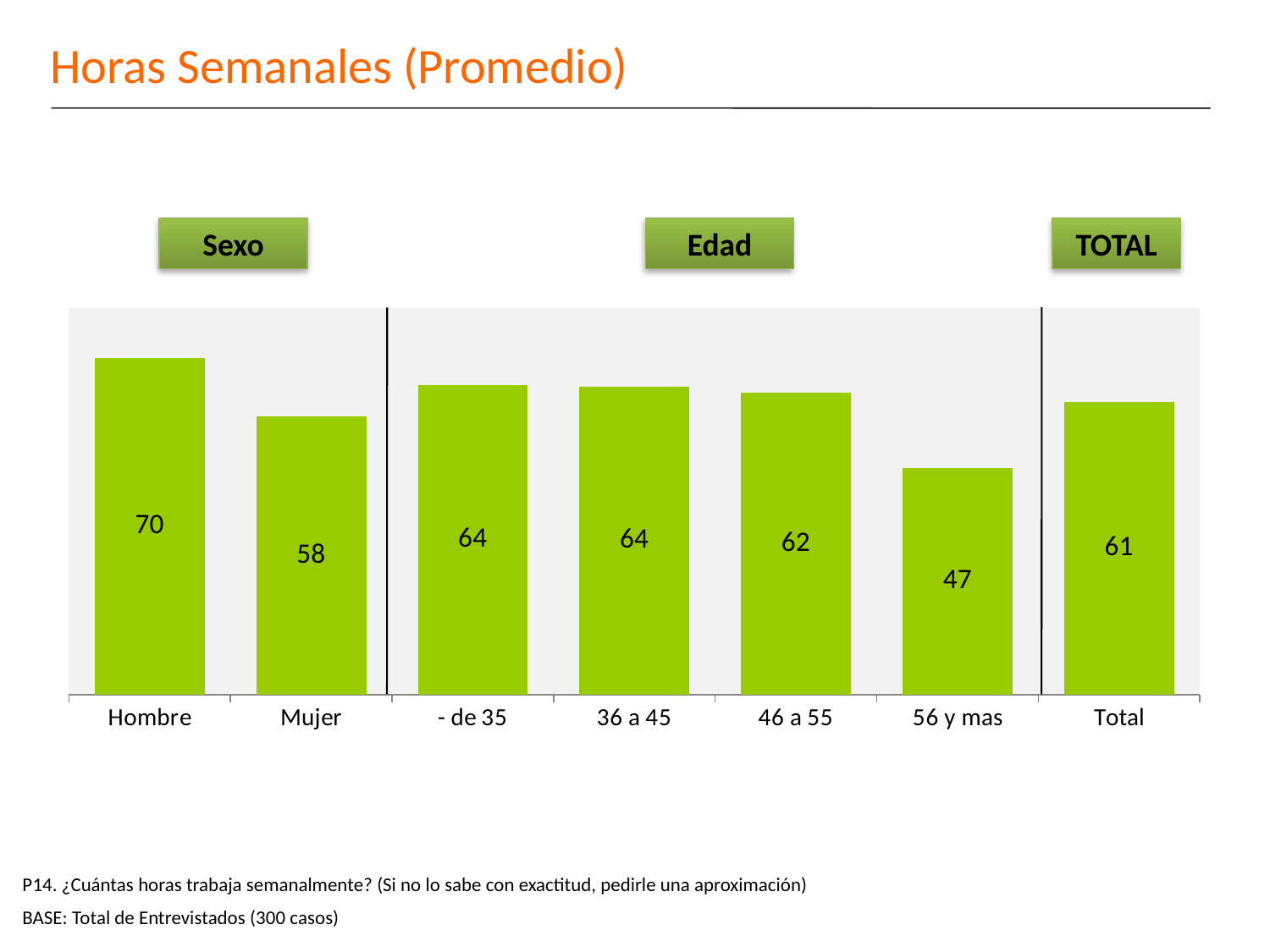
Which is larger, the value for 36 a 45 or the value for 46 a 55? 36 a 45 Which category has the highest value in the chart? Hombre How many bars are plotted in the chart? 7 What is the value shown for Mujer? 58 What is the value shown for the 56 y mas age group? 47 What is the value shown for the Total bar? 61 What is the difference between the values for 46 a 55 and 56 y mas? 15 Which category has the lowest value in the chart? 56 y mas What is the title of the slide's chart? Horas Semanales (Promedio) What type of chart is shown on the slide? Bar chart What is the difference between the values for Hombre and Mujer? 12 What is the average weekly hours value for Hombre? 70